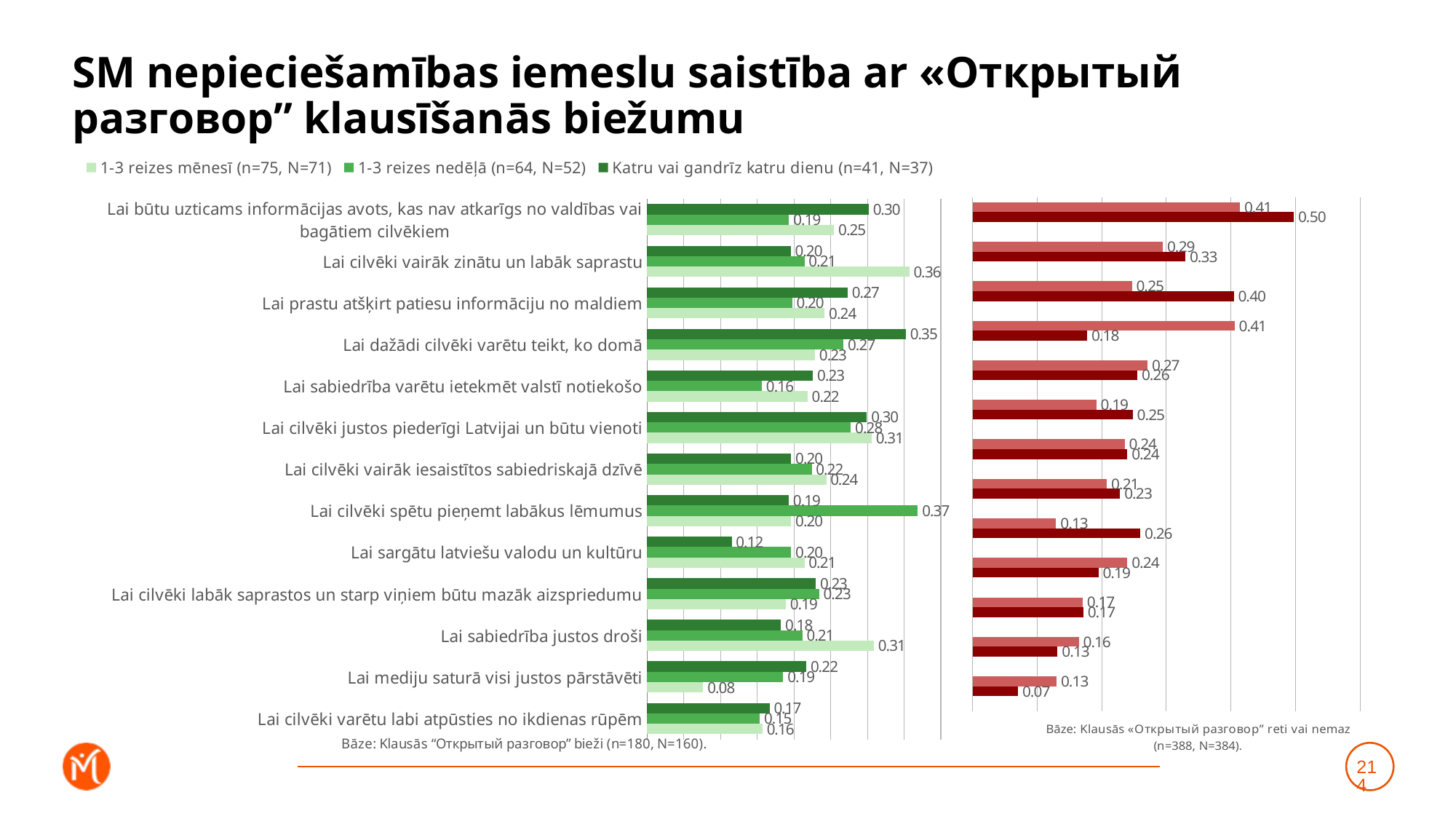
On the green chart, which category has the lowest value for the 'Katru vai gandrīz katru dienu' series? Lai sargātu latviešu valodu un kultūru On the green chart, what is the value for '1-3 reizes mēnesī' for 'Lai sabiedrība justos droši'? 0.31 What is the largest value labelled on the red chart on the right of the slide? 0.50 On the green chart, what is the value for '1-3 reizes nedēļā' for 'Lai cilvēki spētu pieņemt labākus lēmumus'? 0.37 What type of chart is the green chart on the left of the slide? bar chart On the green chart, for 'Lai būtu uzticams informācijas avots, kas nav atkarīgs no valdības vai bagātiem cilvēkiem', which series has the larger value: 'Katru vai gandrīz katru dienu' or '1-3 reizes nedēļā'? Katru vai gandrīz katru dienu On the green chart, for 'Lai mediju saturā visi justos pārstāvēti', what is the difference between the 'Katru vai gandrīz katru dienu' value and the '1-3 reizes mēnesī' value? 0.14 On the green chart, which category has the highest value for the '1-3 reizes mēnesī' series? Lai cilvēki vairāk zinātu un labāk saprastu What base (Bāze) sample sizes are stated under the red chart on the right? n=388, N=384 How many categories (reasons) are listed on the green chart on the left? 13 On the green chart, what is the value for 'Katru vai gandrīz katru dienu' for 'Lai dažādi cilvēki varētu teikt, ko domā'? 0.35 How many series does the legend above the green chart list? 3